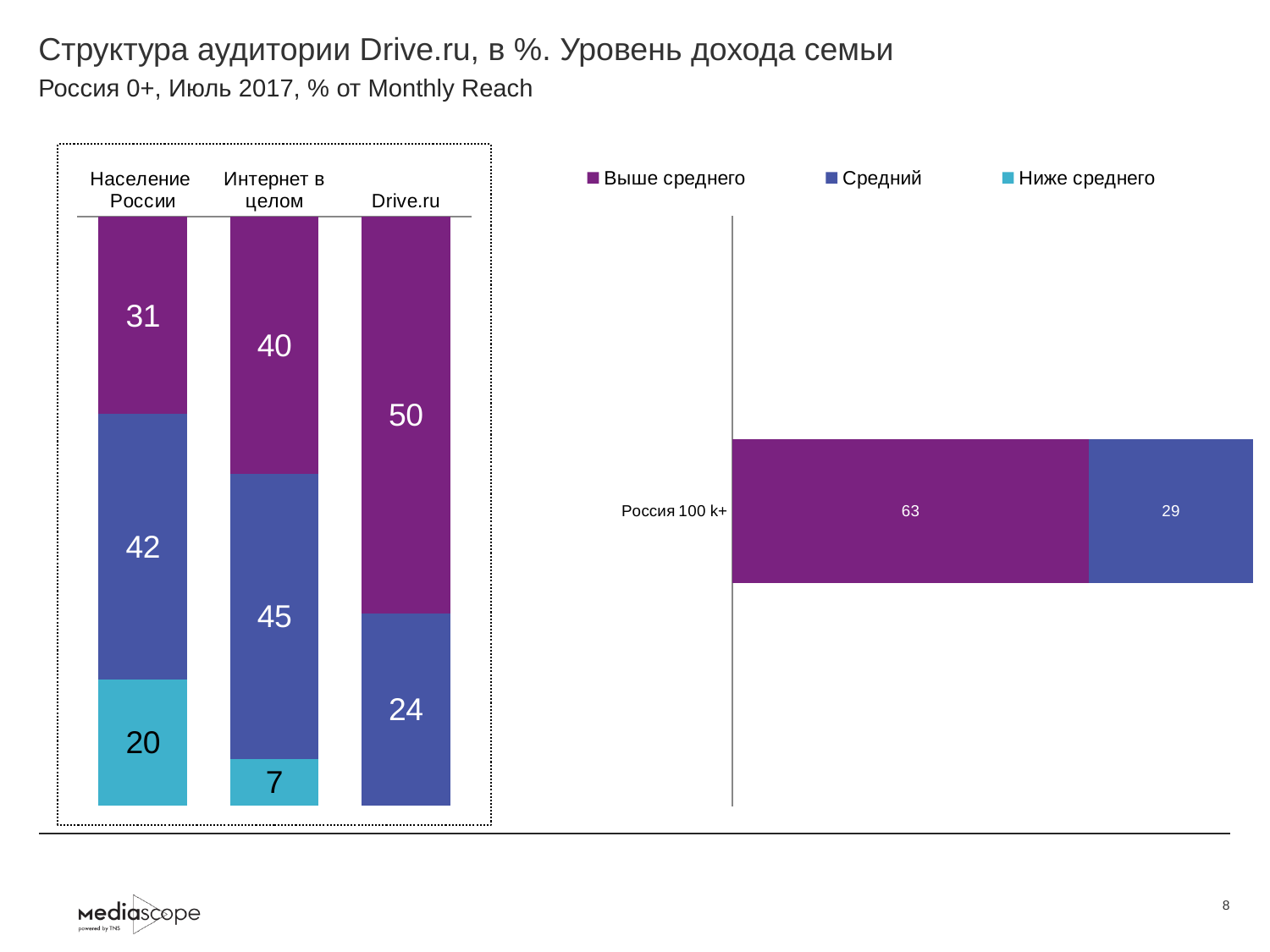
In the left chart, what is the value of Выше среднего for Drive.ru? 50 In the left chart, which category has the highest value for Выше среднего? Drive.ru How many categories are shown in the left chart? 3 In the left chart, what is the value of Ниже среднего for Население России? 20 In the left chart, which is larger: Выше среднего for Население России or Выше среднего for Интернет в целом? Интернет в целом In the left chart, what is the difference between the Ниже среднего values for Население России and Интернет в целом? 13 In the right chart, what is the value of Выше среднего for Россия 100 k+? 63 In the left chart, what is the value of Средний for Интернет в целом? 45 In the left chart, which category has the lowest value for Средний? Drive.ru What kind of chart is the right chart (Россия 100 k+)? Stacked bar chart How many series does the legend list? 3 In the right chart, what is the total of the Россия 100 k+ bar? 92